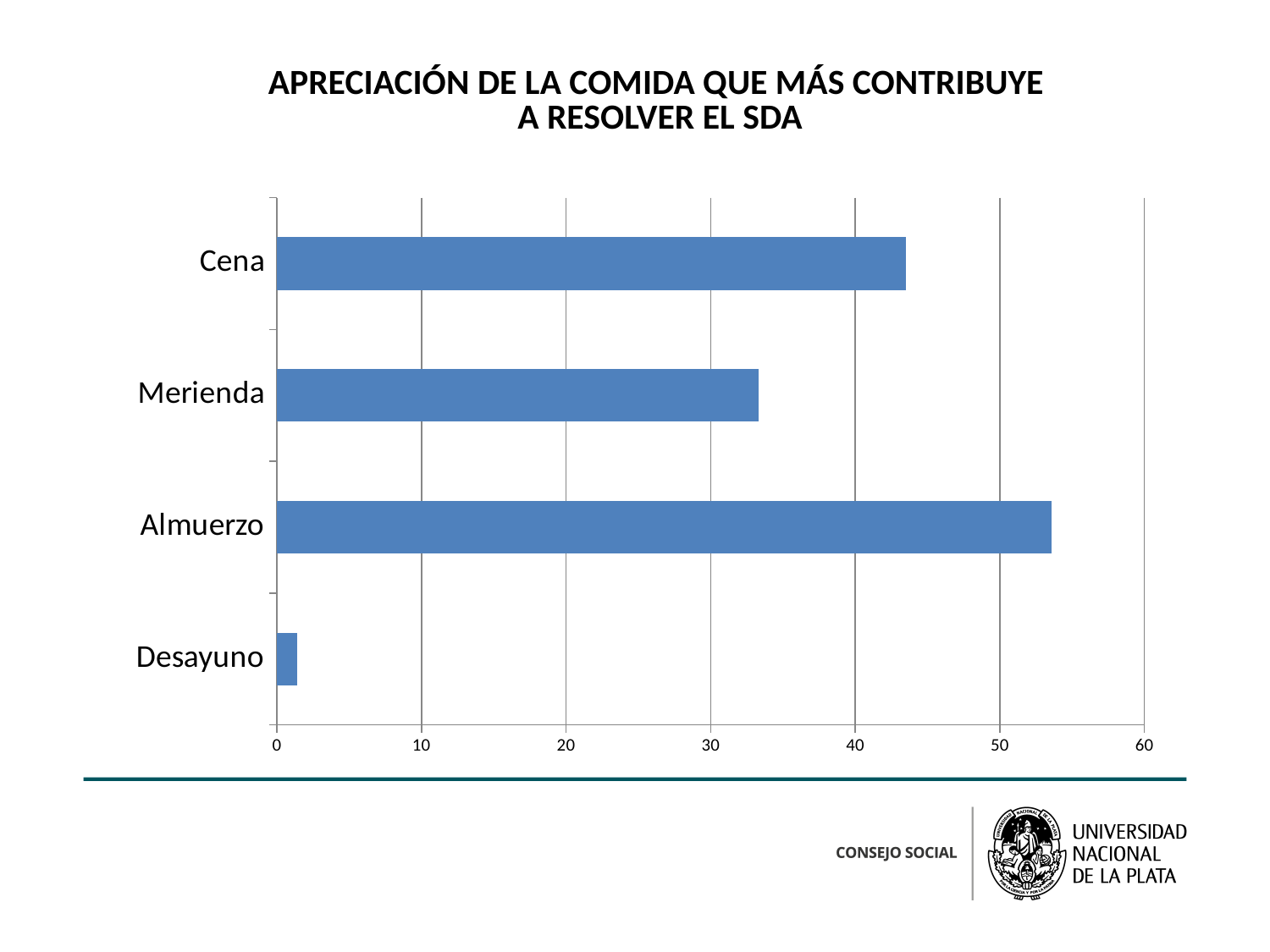
Is the value for Desayuno greater or less than 10? less What kind of chart is shown on the slide? bar chart Which is larger, the value for Cena or the value for Merienda? Cena What is the maximum value shown on the horizontal axis? 60 Is the value for Cena greater or less than 40? greater Which category has the lowest value? Desayuno How many categories are shown in the chart? 4 What is the title of the chart? APRECIACIÓN DE LA COMIDA QUE MÁS CONTRIBUYE A RESOLVER EL SDA Which category has the highest value? Almuerzo Which is larger, the value for Almuerzo or the value for Cena? Almuerzo Is the value for Almuerzo greater or less than 50? greater